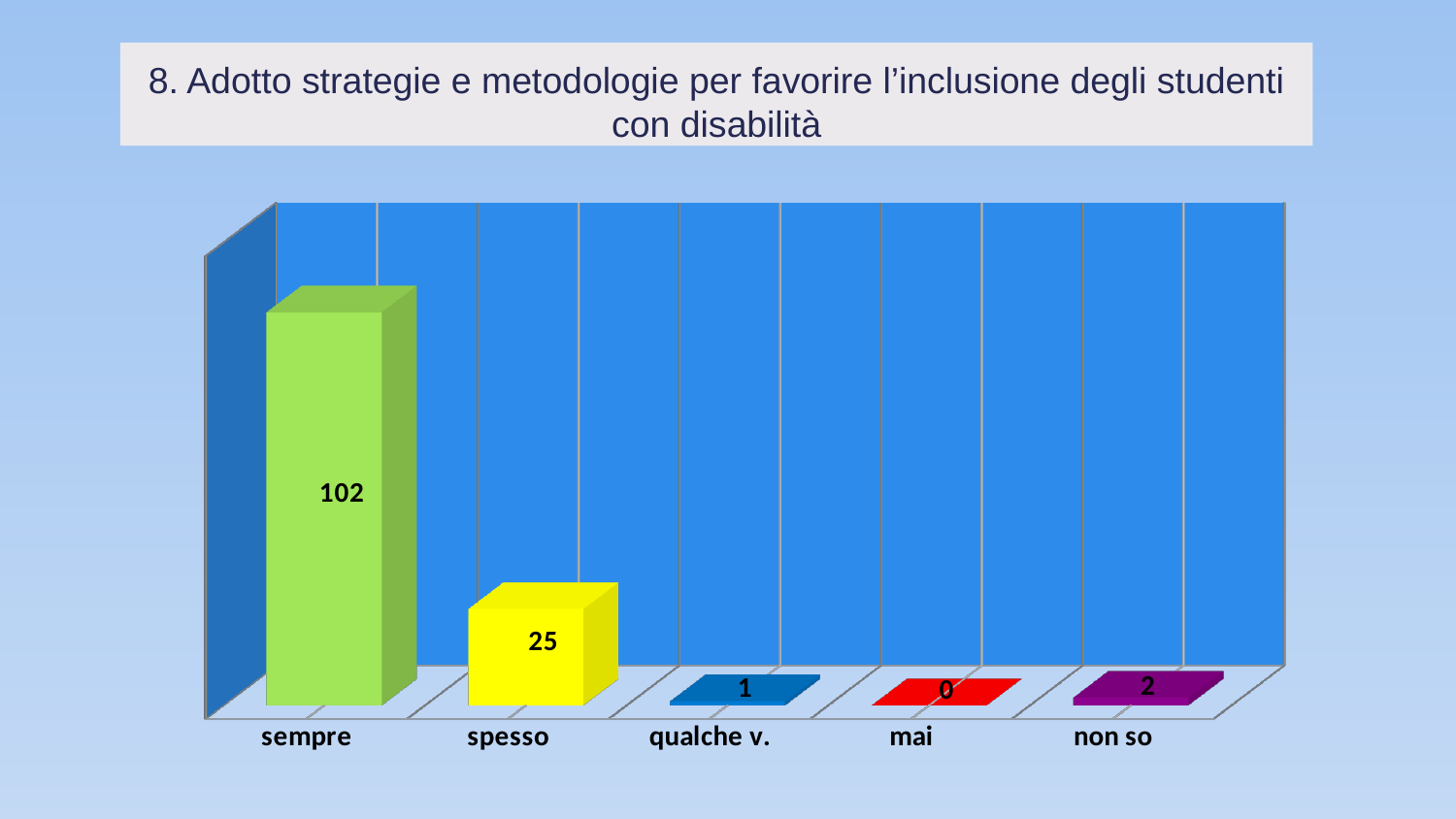
What is the value for "qualche v."? 1 Which is larger, the value for "non so" or the value for "qualche v."? non so What is the value for "non so"? 2 What is the value for "sempre"? 102 What is the difference between the values for "sempre" and "spesso"? 77 Which category has the highest value? sempre What is the value for "mai"? 0 What is the title of the chart? 8. Adotto strategie e metodologie per favorire l’inclusione degli studenti con disabilità How many categories are shown on the x axis? 5 What is the value for "spesso"? 25 Which category has the lowest value? mai What kind of chart is shown on the slide? bar chart